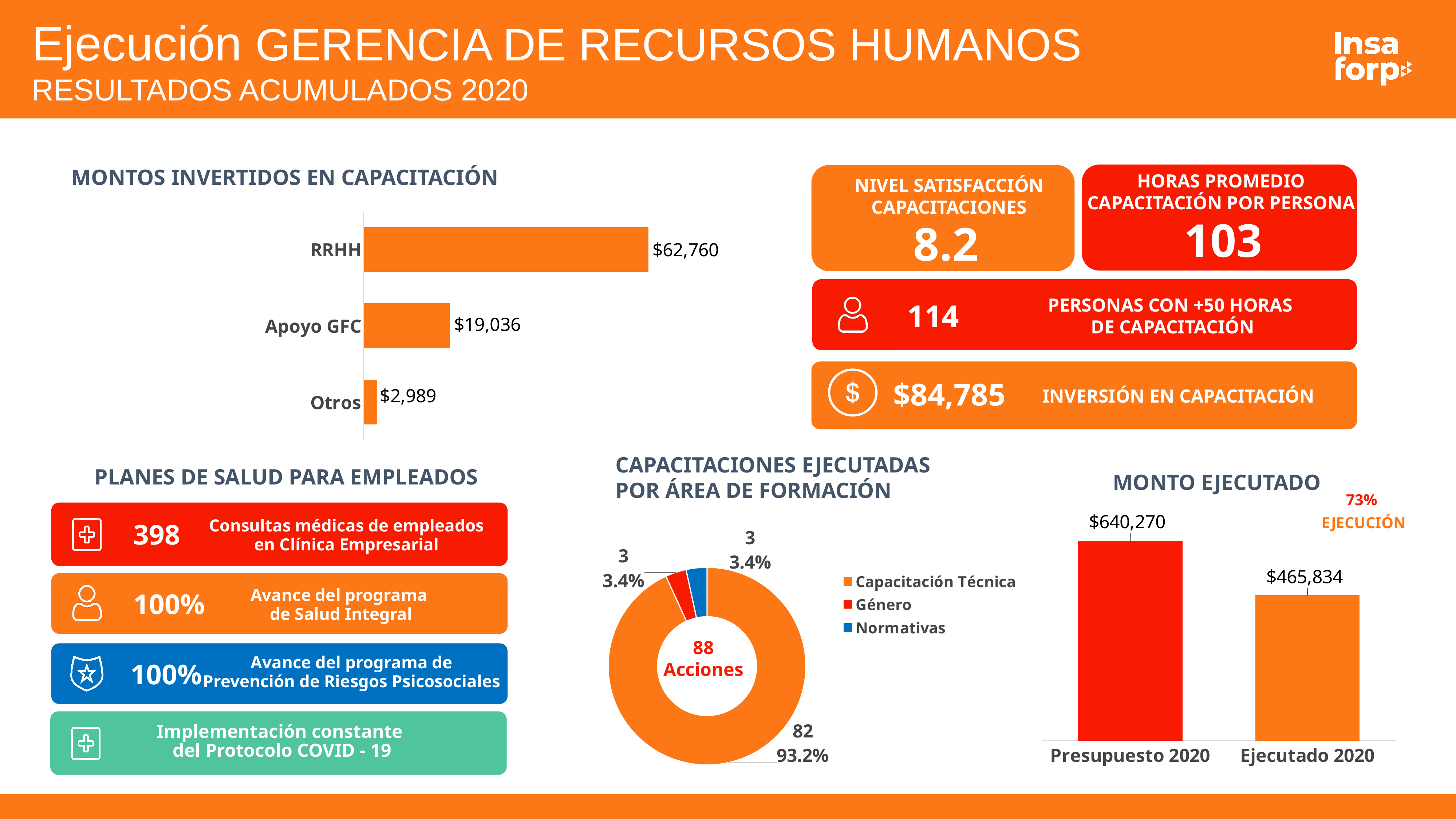
In the 'CAPACITACIONES EJECUTADAS POR ÁREA DE FORMACIÓN' chart, what share does Capacitación Técnica have? 93.2% How many series does the legend of the 'CAPACITACIONES EJECUTADAS POR ÁREA DE FORMACIÓN' chart list? 3 In the 'CAPACITACIONES EJECUTADAS POR ÁREA DE FORMACIÓN' chart, how many actions are in the Género category? 3 What kind of chart is 'MONTOS INVERTIDOS EN CAPACITACIÓN'? Bar chart In the 'MONTO EJECUTADO' chart, what is the value for Ejecutado 2020? $465,834 In the 'MONTOS INVERTIDOS EN CAPACITACIÓN' chart, what is the value for RRHH? $62,760 In the 'MONTOS INVERTIDOS EN CAPACITACIÓN' chart, which category has the lowest value? Otros In the 'MONTO EJECUTADO' chart, which is larger, Presupuesto 2020 or Ejecutado 2020? Presupuesto 2020 In the 'MONTOS INVERTIDOS EN CAPACITACIÓN' chart, how many categories are shown? 3 In the 'MONTOS INVERTIDOS EN CAPACITACIÓN' chart, what is the difference between RRHH and Apoyo GFC? $43,724 In the 'MONTO EJECUTADO' chart, what is the difference between Presupuesto 2020 and Ejecutado 2020? $174,436 In the 'MONTOS INVERTIDOS EN CAPACITACIÓN' chart, what is the value for Apoyo GFC? $19,036